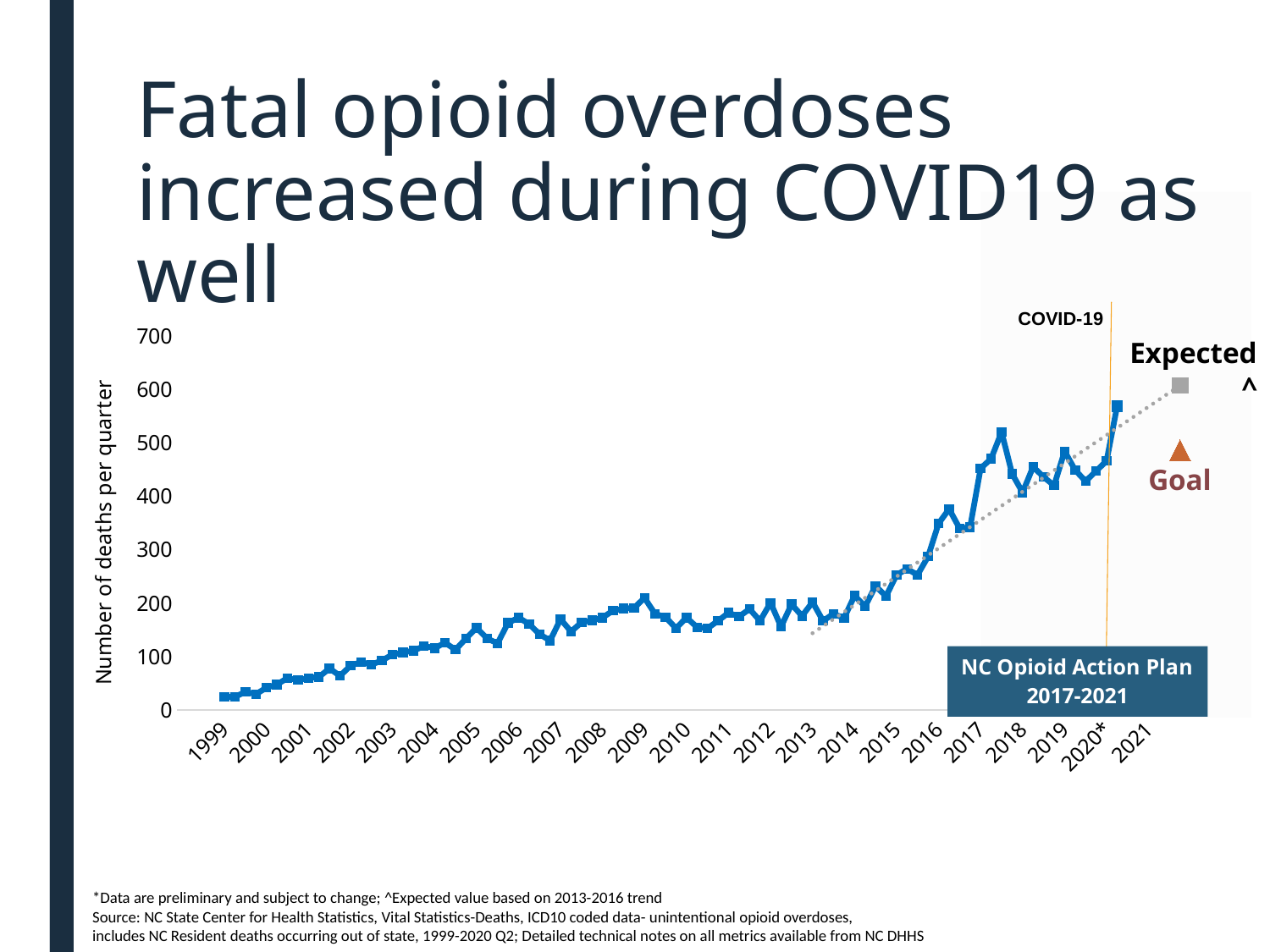
How many year labels are shown along the x axis? 23 Is the last plotted value in 2020 greater or less than 500? greater Is the number of deaths per quarter in 2013 greater or less than 300? less Which year contains the lowest plotted value on the chart? 1999 Is the peak value in 2017 greater or less than 400? greater What is the title of the slide's chart? Fatal opioid overdoses increased during COVID19 as well What kind of chart is shown on the slide? Line chart What is the label on the vertical axis of the chart? Number of deaths per quarter Which year has a higher number of deaths per quarter, 2005 or 2016? 2016 Overall, do the number of deaths per quarter rise or fall from 1999 to 2020? Rise